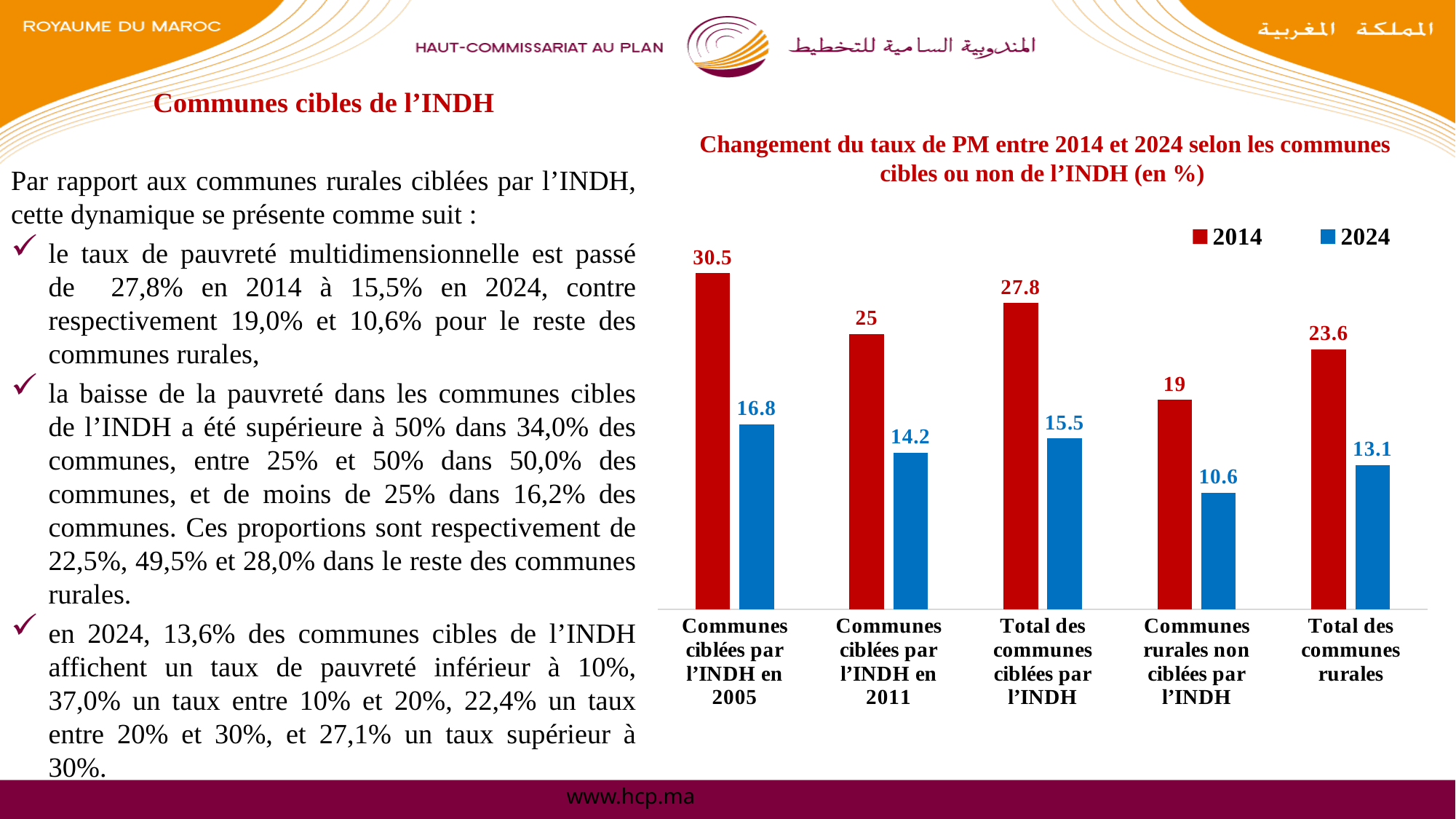
What is the 2014 value for Communes ciblées par l'INDH en 2005? 30.5 What is the 2014 value for Total des communes rurales? 23.6 What is the 2024 value for Communes rurales non ciblées par l'INDH? 10.6 Which colour represents the 2024 series in the chart? Blue What is the difference between the 2014 and 2024 values for Communes ciblées par l'INDH en 2011? 10.8 How many categories are shown on the x axis of the chart? 5 Which is larger: the 2024 value for Communes ciblées par l'INDH en 2005 or the 2024 value for Total des communes rurales? Communes ciblées par l'INDH en 2005 What kind of chart is shown on the slide? Bar chart Which category has the highest 2014 value? Communes ciblées par l'INDH en 2005 Which category has the lowest 2024 value? Communes rurales non ciblées par l'INDH What is the 2024 value for Total des communes ciblées par l'INDH? 15.5 How many series does the legend list? 2